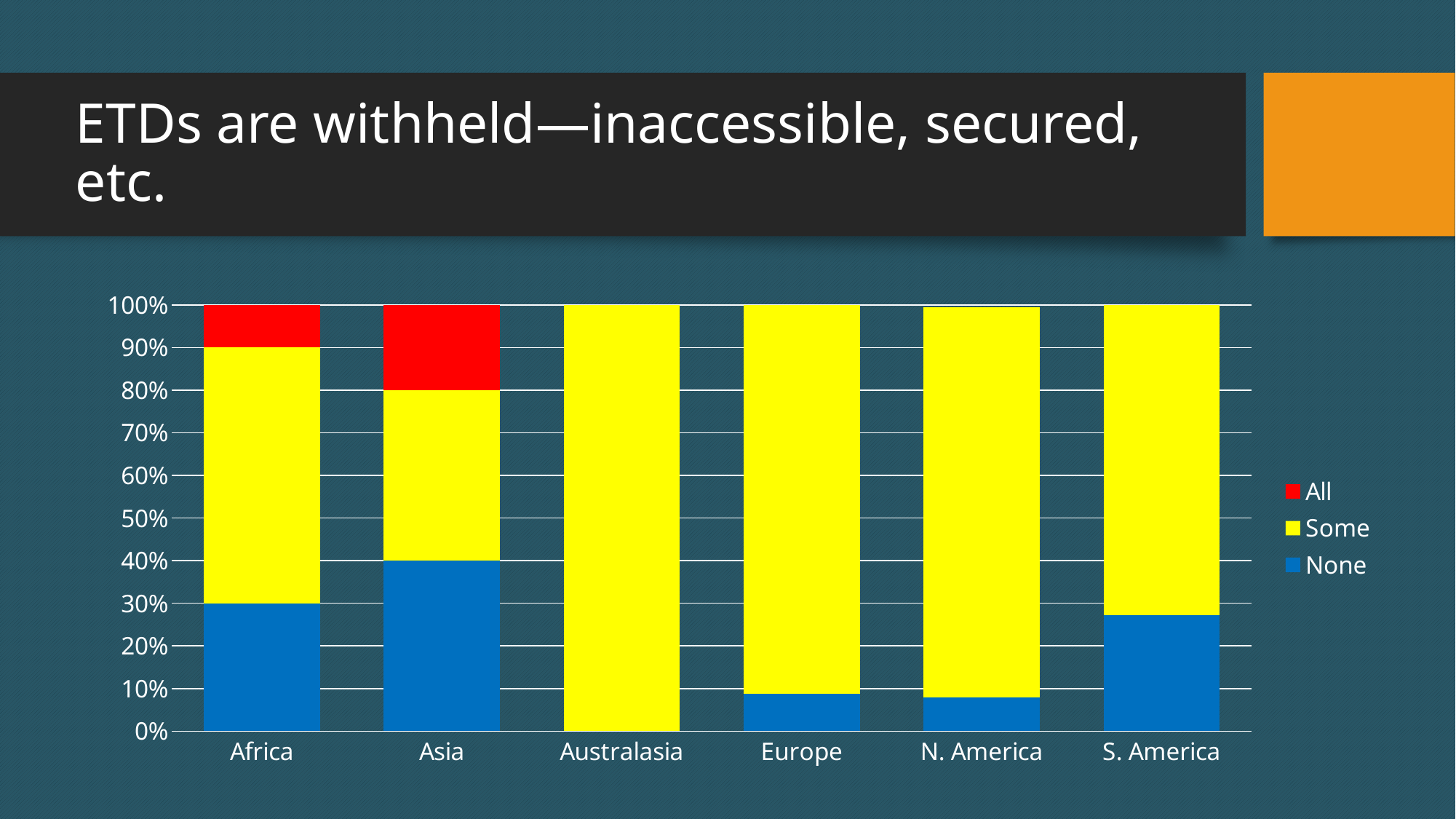
Which series is shown in red in the chart? All Is the None value for S. America greater or less than 20%? greater What is the value of the None series for Asia? 40% What kind of chart is shown on the slide? stacked bar chart Which region has the largest None (blue) segment? Asia Which region's bar consists entirely of the Some series? Australasia Which region has the largest All (red) segment? Asia How many regions are shown on the x axis of the chart? 6 What is the value of the None series for Africa? 30% How many series does the chart legend list? 3 Which is larger, the None value for Africa or the None value for N. America? Africa Is the None value for Europe greater or less than 10%? less